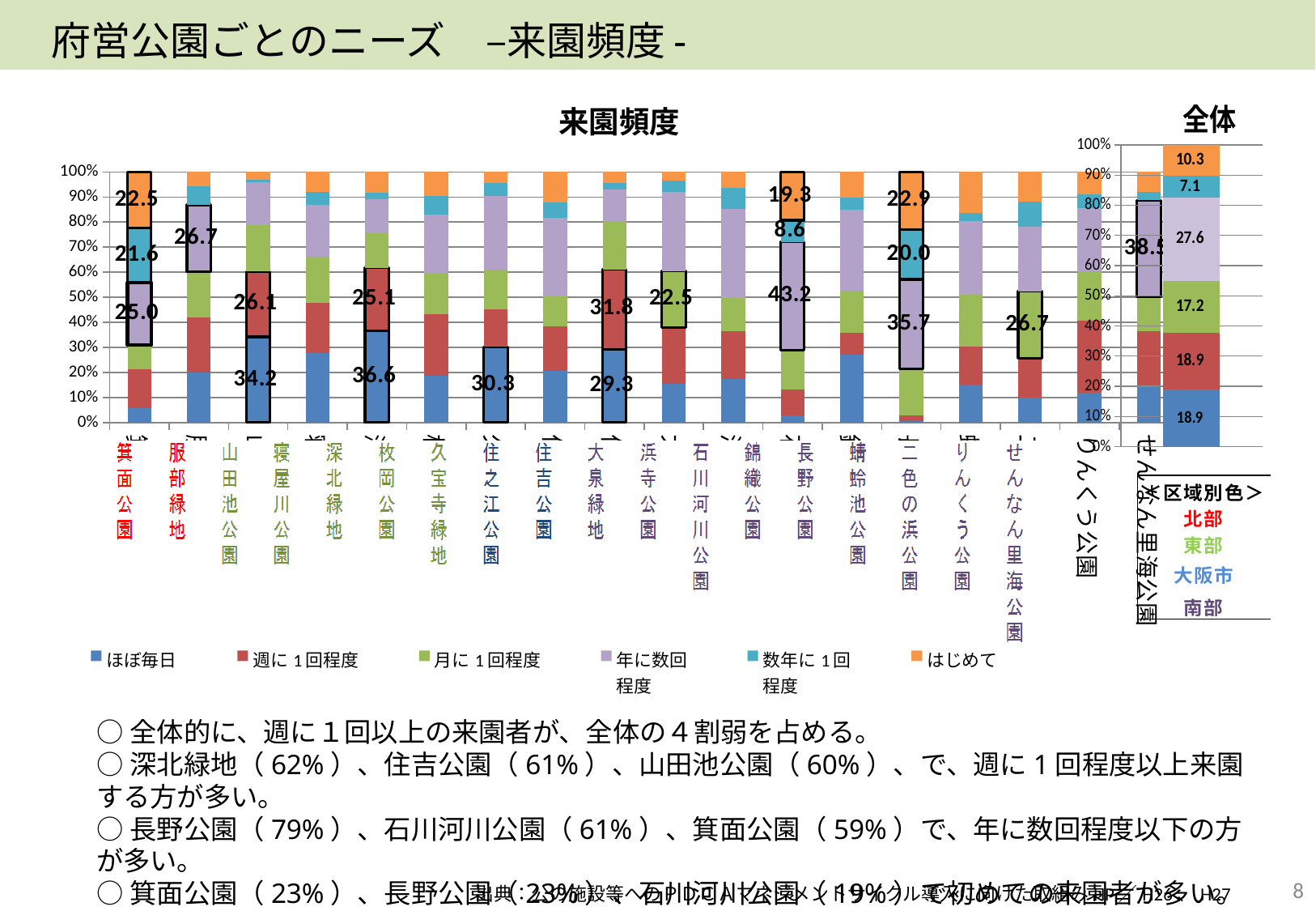
In the 全体 chart, which segment has the largest value? 年に数回程度 In the 来園頻度 chart, what is the value of はじめて for 箕面公園? 22.5 In the 全体 chart, what is the value of ほぼ毎日? 18.9 In the 来園頻度 chart, how many series does the legend list? 6 In the 全体 chart, what is the value of 年に数回程度? 27.6 In the 来園頻度 chart, what is the value of 年に数回程度 for 長野公園? 35.7 In the 来園頻度 chart, which has the larger ほぼ毎日 value, 枚岡公園 or 寝屋川公園? 寝屋川公園 In the 来園頻度 chart, what kind of chart is used? stacked bar chart In the 来園頻度 chart, how many parks are shown on the x axis? 18